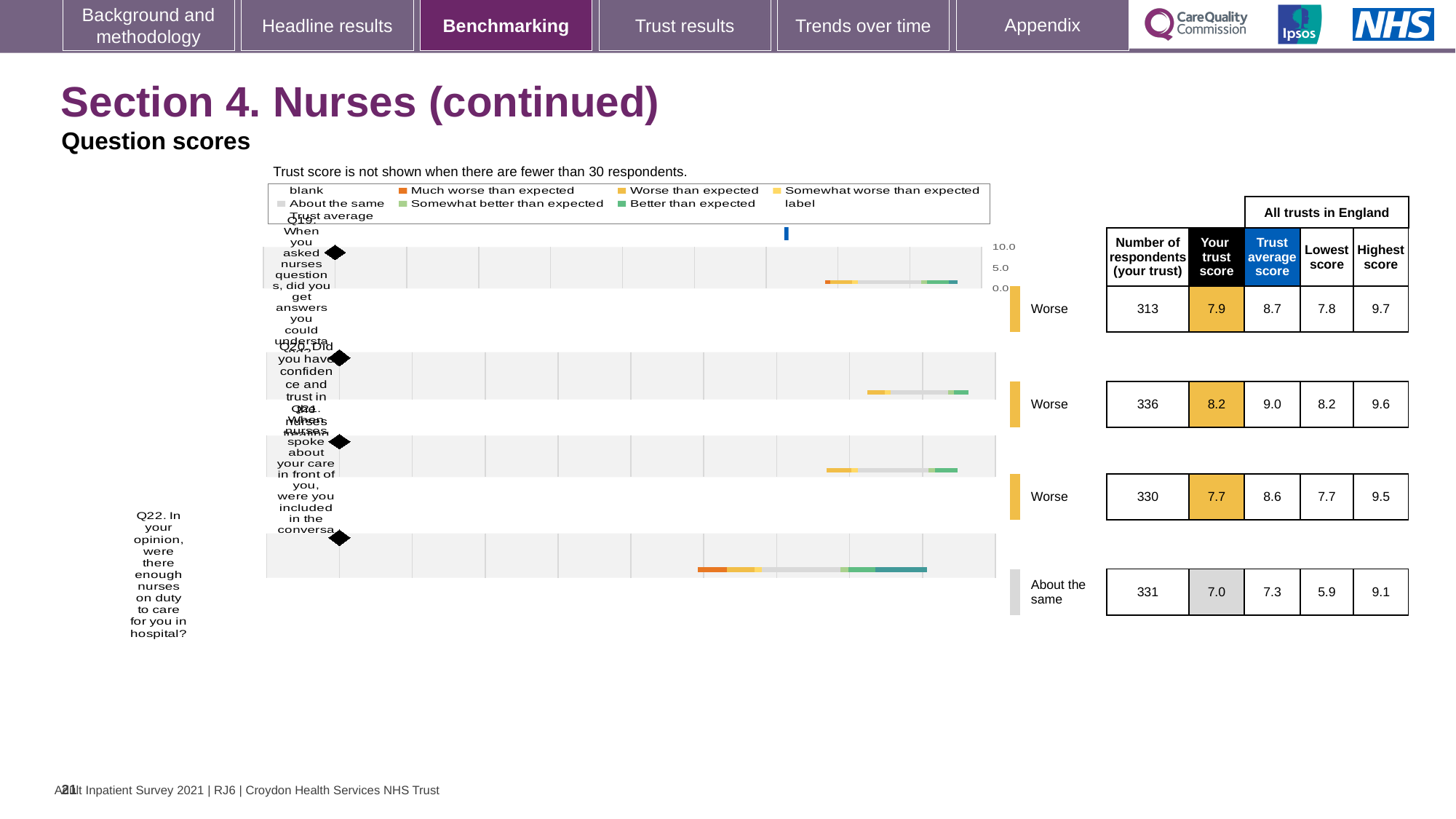
What is the highest score across all trusts in England for Q21? 9.5 How many questions (categories) are plotted in the chart? 4 For Q21, which is larger: your trust score or the trust average score? Trust average score Which benchmark category is Q22 assigned to? About the same What kind of chart is shown on the slide? bar chart What is the difference between the trust average score and your trust score for Q19? 0.8 Which question has the lowest 'Your trust score'? Q22 What is the trust average score for Q20 (Did you have confidence and trust in the nurses)? 9.0 What is the 'Your trust score' for Q19 (When you asked nurses questions, did you get answers you could understand)? 7.9 What is the number of respondents for Q22 (were there enough nurses on duty)? 331 What is the lowest score across all trusts in England for Q22? 5.9 Which question has the highest 'Your trust score'? Q20